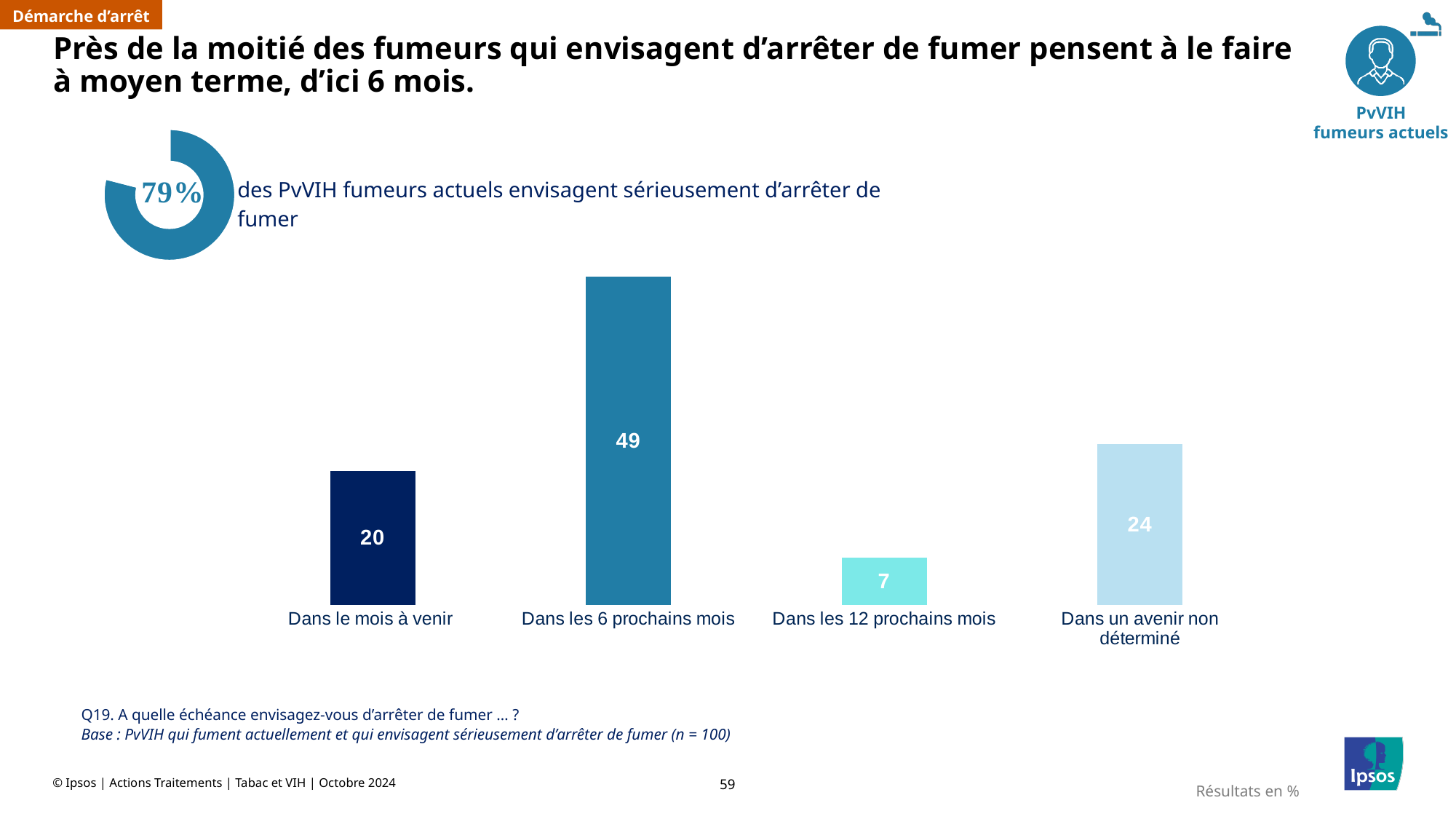
Which category has the lowest value in the bar chart? Dans les 12 prochains mois How many categories are shown in the bar chart? 4 What is the value for "Dans le mois à venir" in the bar chart? 20 Which category has the highest value in the bar chart? Dans les 6 prochains mois What kind of chart is used to show the timeframes for quitting smoking? Bar chart What is the value for "Dans les 6 prochains mois" in the bar chart? 49 What is the value for "Dans les 12 prochains mois" in the bar chart? 7 What is the difference between the values for "Dans les 6 prochains mois" and "Dans un avenir non déterminé"? 25 What is the value for "Dans un avenir non déterminé" in the bar chart? 24 What is the difference between the values for "Dans le mois à venir" and "Dans les 12 prochains mois"? 13 What percentage is shown in the donut chart at the top left of the slide? 79 % Which is larger: the value for "Dans le mois à venir" or the value for "Dans un avenir non déterminé"? Dans un avenir non déterminé